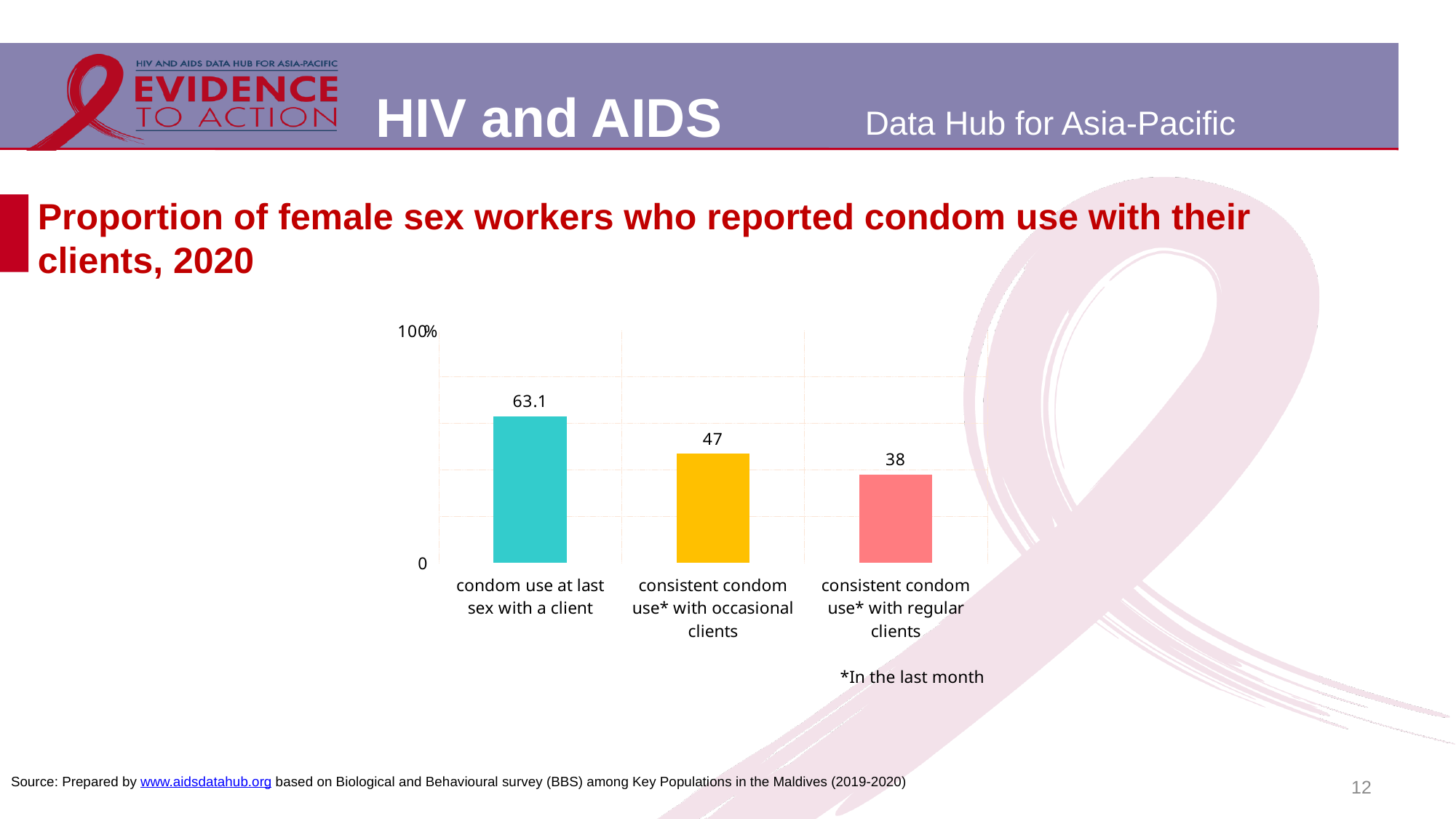
What kind of chart is shown on the slide? bar chart Which category has the lowest value? consistent condom use with regular clients Which is larger: the value for consistent condom use with occasional clients or the value for consistent condom use with regular clients? consistent condom use with occasional clients What is the value for consistent condom use with occasional clients? 47 What is the difference between the value for consistent condom use with occasional clients and the value for consistent condom use with regular clients? 9 What is the title of the chart on the slide? Proportion of female sex workers who reported condom use with their clients, 2020 What is the value for consistent condom use with regular clients? 38 What is the difference between the value for condom use at last sex with a client and the value for consistent condom use with regular clients? 25.1 Do the values rise or fall from left to right across the categories? fall Which category has the highest value? condom use at last sex with a client What is the value for condom use at last sex with a client? 63.1 How many categories are shown in the chart? 3